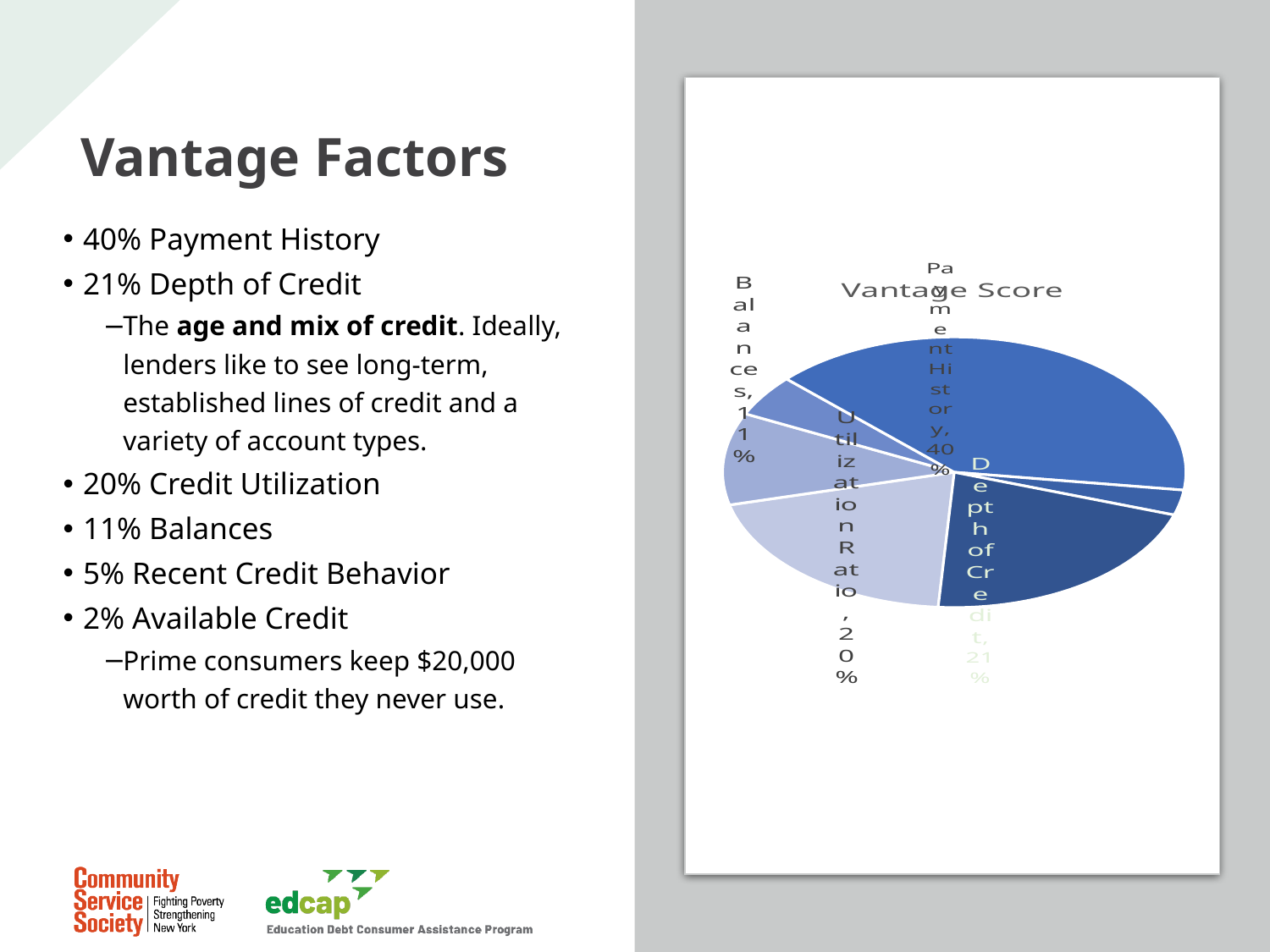
What is the difference between the Payment History and Depth of Credit percentages? 19% What percentage does the Balances slice show in the Vantage Score pie chart? 11% What is the title of the chart? Vantage Score What share of the Vantage Score pie does Depth of Credit take? 21% Which is larger in the Vantage Score pie chart, Payment History or Balances? Payment History What kind of chart is shown on the slide? pie chart What percentage does the Depth of Credit slice show in the Vantage Score pie chart? 21% What is the difference between the Utilization Ratio and Balances percentages? 9% How many slices does the Vantage Score pie chart have? 6 What percentage does the Payment History slice show in the Vantage Score pie chart? 40% Which labeled slice is the largest in the Vantage Score pie chart? Payment History What percentage does the Utilization Ratio slice show in the Vantage Score pie chart? 20%